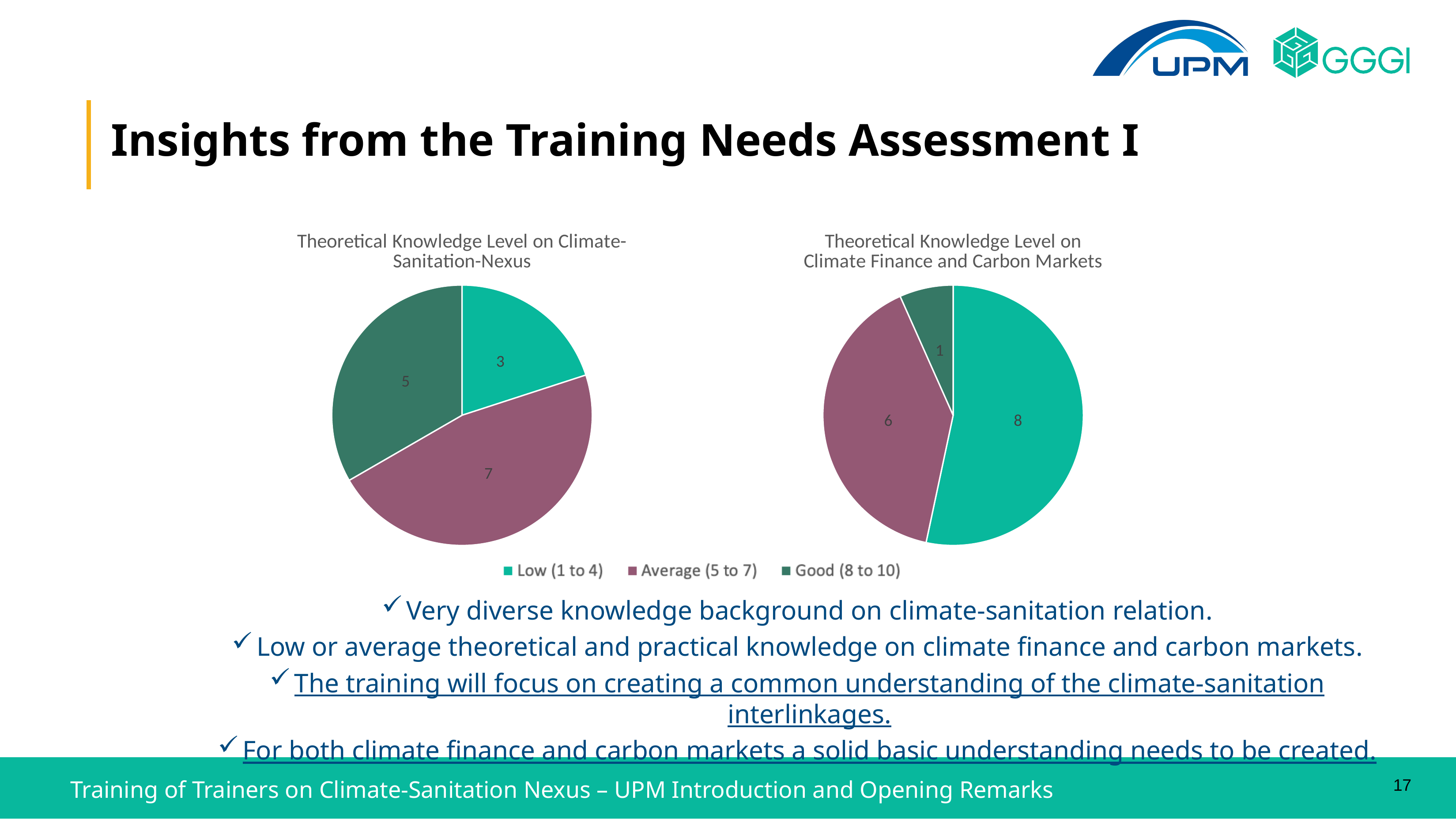
In the 'Theoretical Knowledge Level on Climate Finance and Carbon Markets' chart, which category has the smallest slice? Good (8 to 10) In the 'Theoretical Knowledge Level on Climate Finance and Carbon Markets' chart, what share of the total does Average (5 to 7) represent? 40% In the 'Theoretical Knowledge Level on Climate-Sanitation-Nexus' chart, what is the value for Average (5 to 7)? 7 In the 'Theoretical Knowledge Level on Climate-Sanitation-Nexus' chart, what share of the total does Low (1 to 4) represent? 20% In the 'Theoretical Knowledge Level on Climate Finance and Carbon Markets' chart, what is the difference between the Low (1 to 4) and Average (5 to 7) values? 2 In the 'Theoretical Knowledge Level on Climate Finance and Carbon Markets' chart, what is the value for Low (1 to 4)? 8 In the 'Theoretical Knowledge Level on Climate Finance and Carbon Markets' chart, what is the value for Good (8 to 10)? 1 In the 'Theoretical Knowledge Level on Climate-Sanitation-Nexus' chart, which is larger: Good (8 to 10) or Low (1 to 4)? Good (8 to 10) What type of chart is used for 'Theoretical Knowledge Level on Climate-Sanitation-Nexus'? Pie chart How many categories does the legend list for the pie charts? 3 In the 'Theoretical Knowledge Level on Climate-Sanitation-Nexus' chart, what is the value for Low (1 to 4)? 3 In the 'Theoretical Knowledge Level on Climate-Sanitation-Nexus' chart, which category has the largest slice? Average (5 to 7)